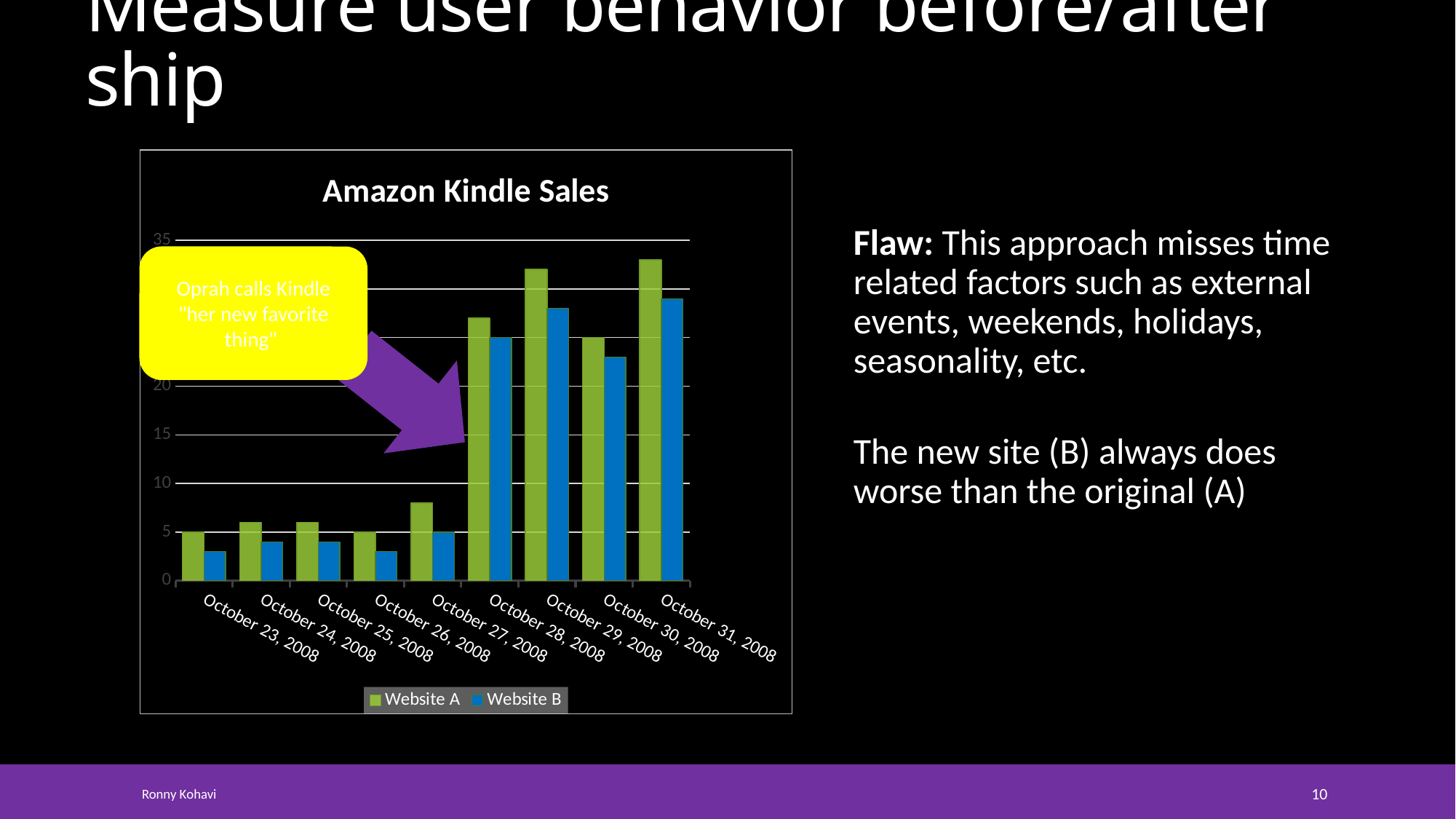
Which colour represents Website B in the chart? blue On October 28, 2008, which series has the larger value, Website A or Website B? Website A What is the value for Website A on October 23, 2008? 5 How many series does the chart's legend list? 2 What is the title of the chart? Amazon Kindle Sales Is the value for Website B on October 24, 2008 greater or less than 5? less What is the value for Website B on October 27, 2008? 5 Which is larger for Website A: the value on October 27, 2008 or the value on October 23, 2008? October 27, 2008 What kind of chart is shown on the slide? bar chart Is the value for Website B on October 28, 2008 greater or less than 20? greater How many dates are shown along the x axis of the chart? 9 Is the value for Website A on October 29, 2008 greater or less than 30? greater